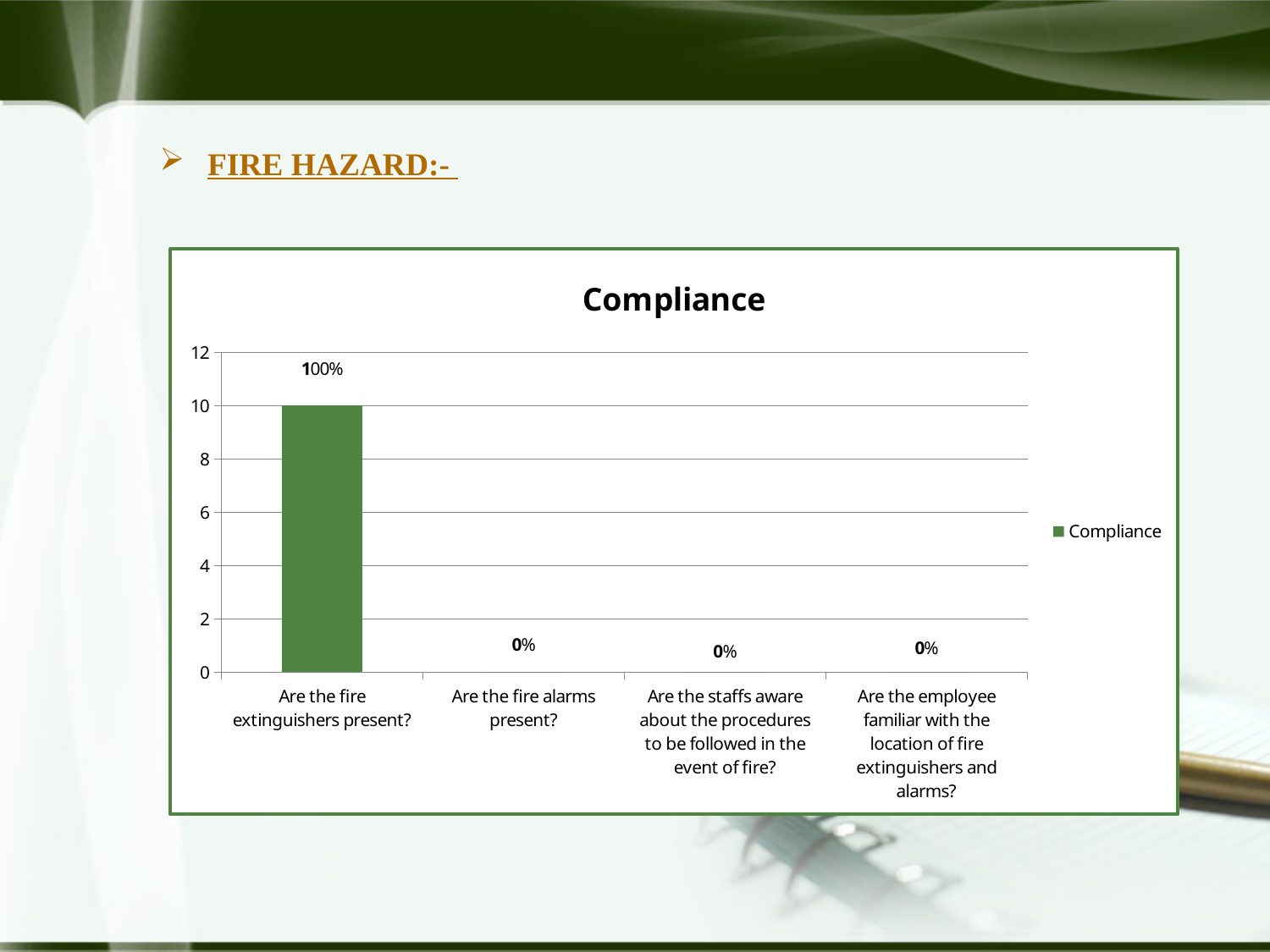
Is the bar for 'Are the fire extinguishers present?' greater or less than 8 on the y axis? greater Which is larger: the value for 'Are the fire extinguishers present?' or the value for 'Are the fire alarms present?' Are the fire extinguishers present? What is the data label shown for 'Are the fire extinguishers present?' 100% What is the data label shown for 'Are the employee familiar with the location of fire extinguishers and alarms?' 0% Which category has the highest value in the chart? Are the fire extinguishers present? What type of chart is shown on the slide? bar chart What is the name of the series shown in the legend? Compliance How many series does the legend list? 1 What is the title of the chart? Compliance What is the data label shown for 'Are the staffs aware about the procedures to be followed in the event of fire?' 0% What is the data label shown for 'Are the fire alarms present?' 0% How many categories are shown on the x axis of the chart? 4